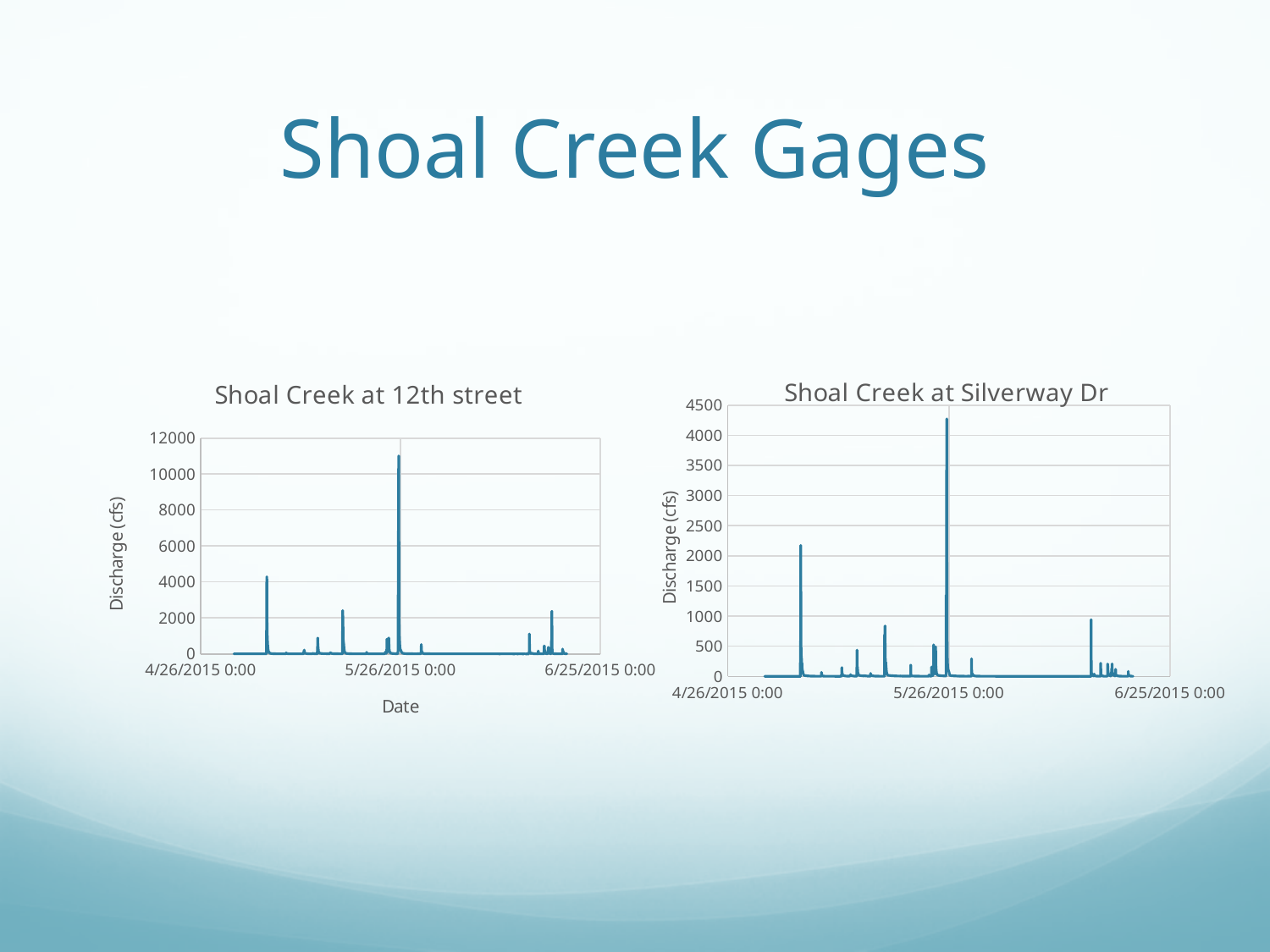
What kind of chart is 'Shoal Creek at Silverway Dr'? line chart In the 'Shoal Creek at 12th street' chart, does the highest peak occur near 5/26/2015 0:00 or near 6/25/2015 0:00? 5/26/2015 0:00 Which chart has the higher maximum y-axis value, 'Shoal Creek at 12th street' or 'Shoal Creek at Silverway Dr'? Shoal Creek at 12th street In the 'Shoal Creek at Silverway Dr' chart, is the first large peak (shortly after 4/26/2015) greater or less than 1500? greater In the 'Shoal Creek at 12th street' chart, is the highest peak greater or less than 10000? greater What is the y-axis label of the 'Shoal Creek at 12th street' chart? Discharge (cfs) What kind of chart is 'Shoal Creek at 12th street'? line chart In the 'Shoal Creek at 12th street' chart, is the first large peak (before 5/26/2015) greater or less than 6000? less What is the highest y-axis tick value shown on the 'Shoal Creek at Silverway Dr' chart? 4500